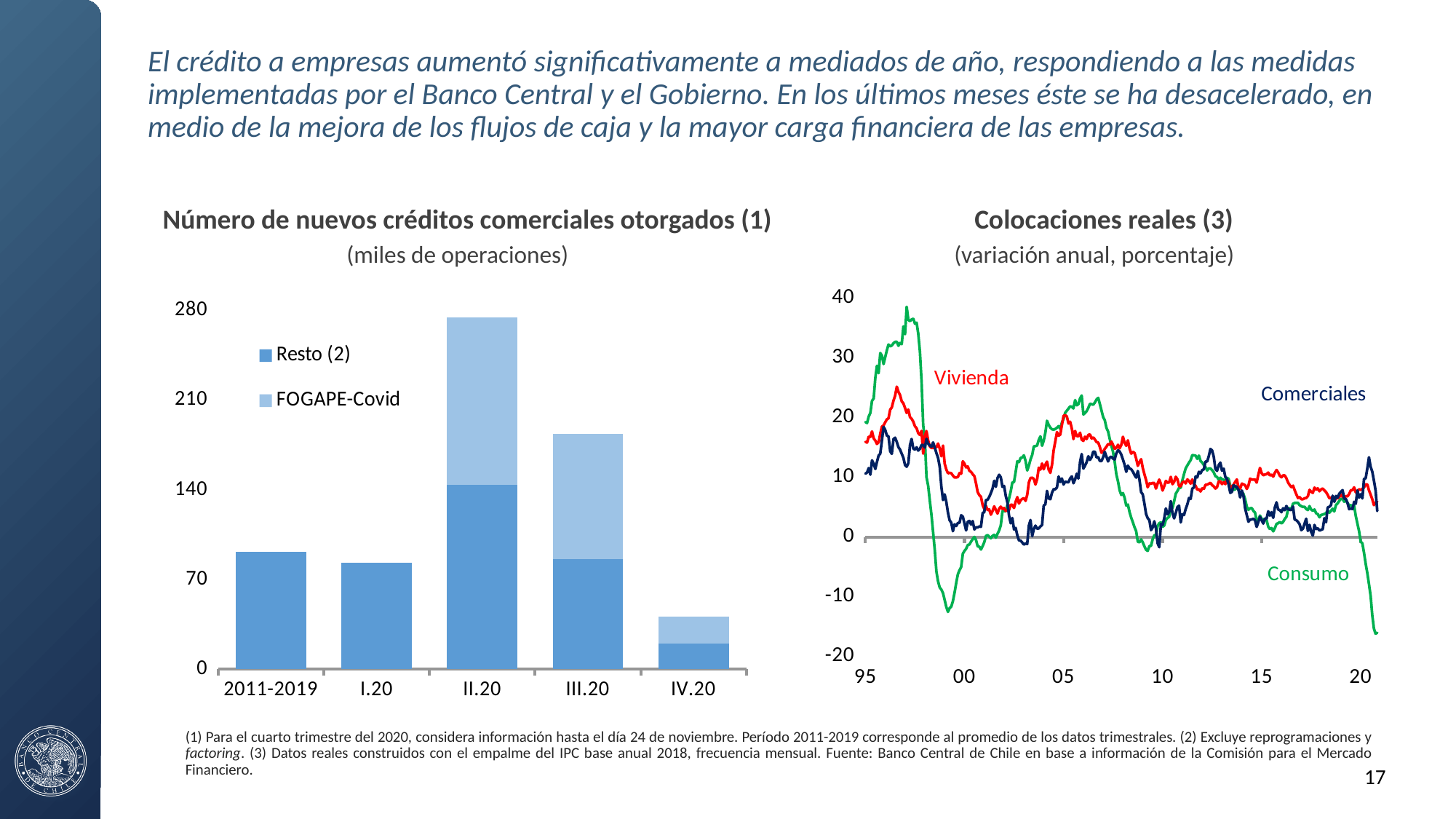
In the 'Número de nuevos créditos comerciales otorgados (1)' chart, which category has the shortest stacked bar? IV.20 How many series does the legend of the 'Número de nuevos créditos comerciales otorgados (1)' chart list? 2 In the 'Número de nuevos créditos comerciales otorgados (1)' chart, which stacked bar is taller, II.20 or III.20? II.20 What kind of chart is the 'Número de nuevos créditos comerciales otorgados (1)' chart on the left? Bar chart In the 'Número de nuevos créditos comerciales otorgados (1)' chart, is the total for IV.20 greater or less than 70? less How many series are plotted in the 'Colocaciones reales (3)' chart? 3 In the 'Número de nuevos créditos comerciales otorgados (1)' chart, is the value for 2011-2019 greater or less than 70? greater How many categories are shown on the x axis of the 'Número de nuevos créditos comerciales otorgados (1)' chart? 5 In the 'Colocaciones reales (3)' chart, which series drops below -10 at the end of the period around 2020? Consumo What kind of chart is the 'Colocaciones reales (3)' chart on the right? Line chart In the 'Número de nuevos créditos comerciales otorgados (1)' chart, is the total for II.20 greater or less than 210? greater In the 'Número de nuevos créditos comerciales otorgados (1)' chart, which category has the tallest stacked bar? II.20